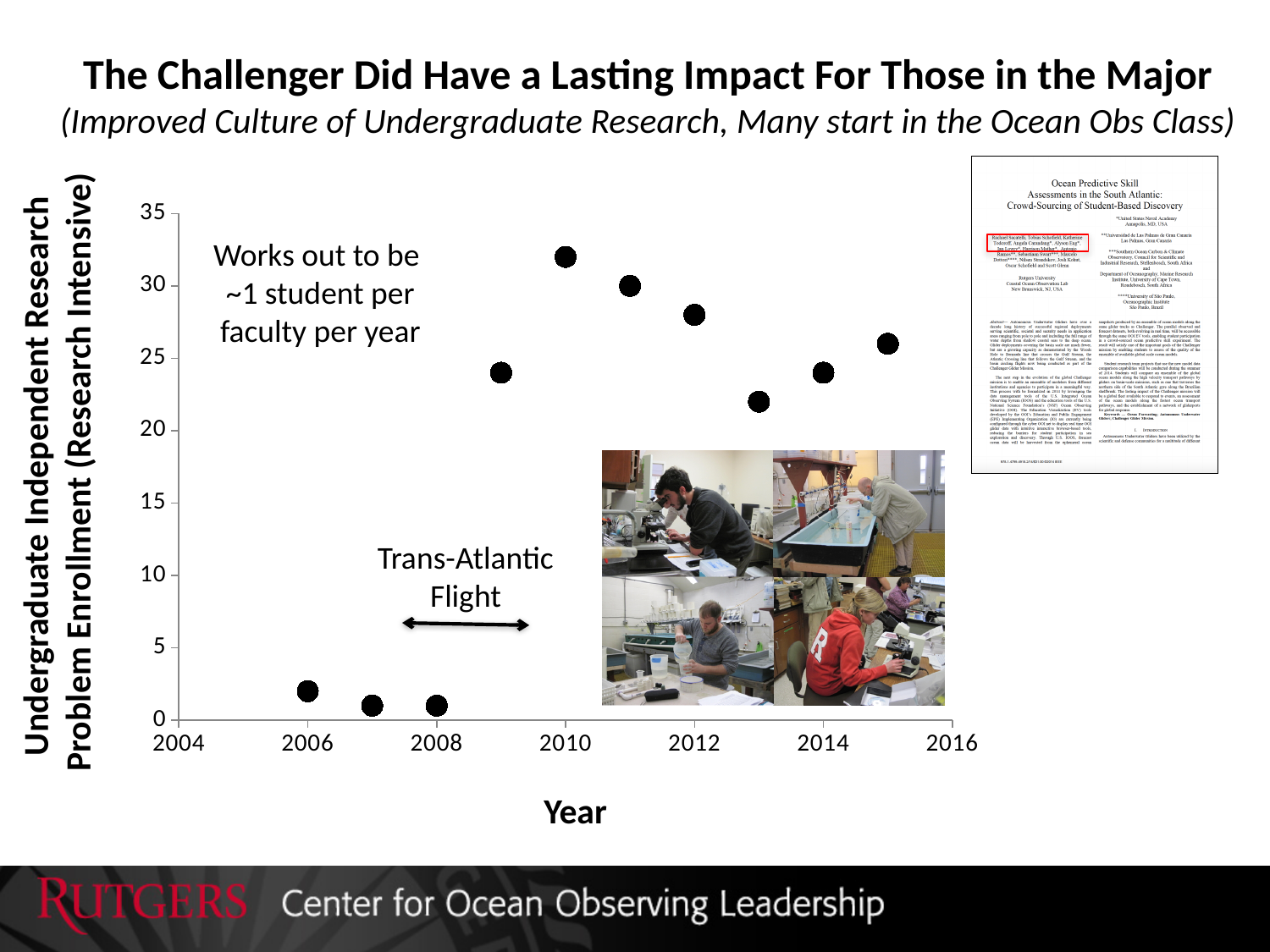
Which year has the highest undergraduate independent research problem enrollment? 2010 What is the title of the x axis? Year Is the value for 2010 greater or less than 30? greater Do the enrollment values generally rise or fall from 2006 to 2015? rise How many data points are plotted on the chart? 10 What kind of chart is shown on the slide? scatter plot Which year has the larger enrollment value, 2011 or 2013? 2011 Is the value for 2006 greater or less than 5? less Which year has the larger enrollment value, 2008 or 2012? 2012 Is the value for 2013 greater or less than 20? greater